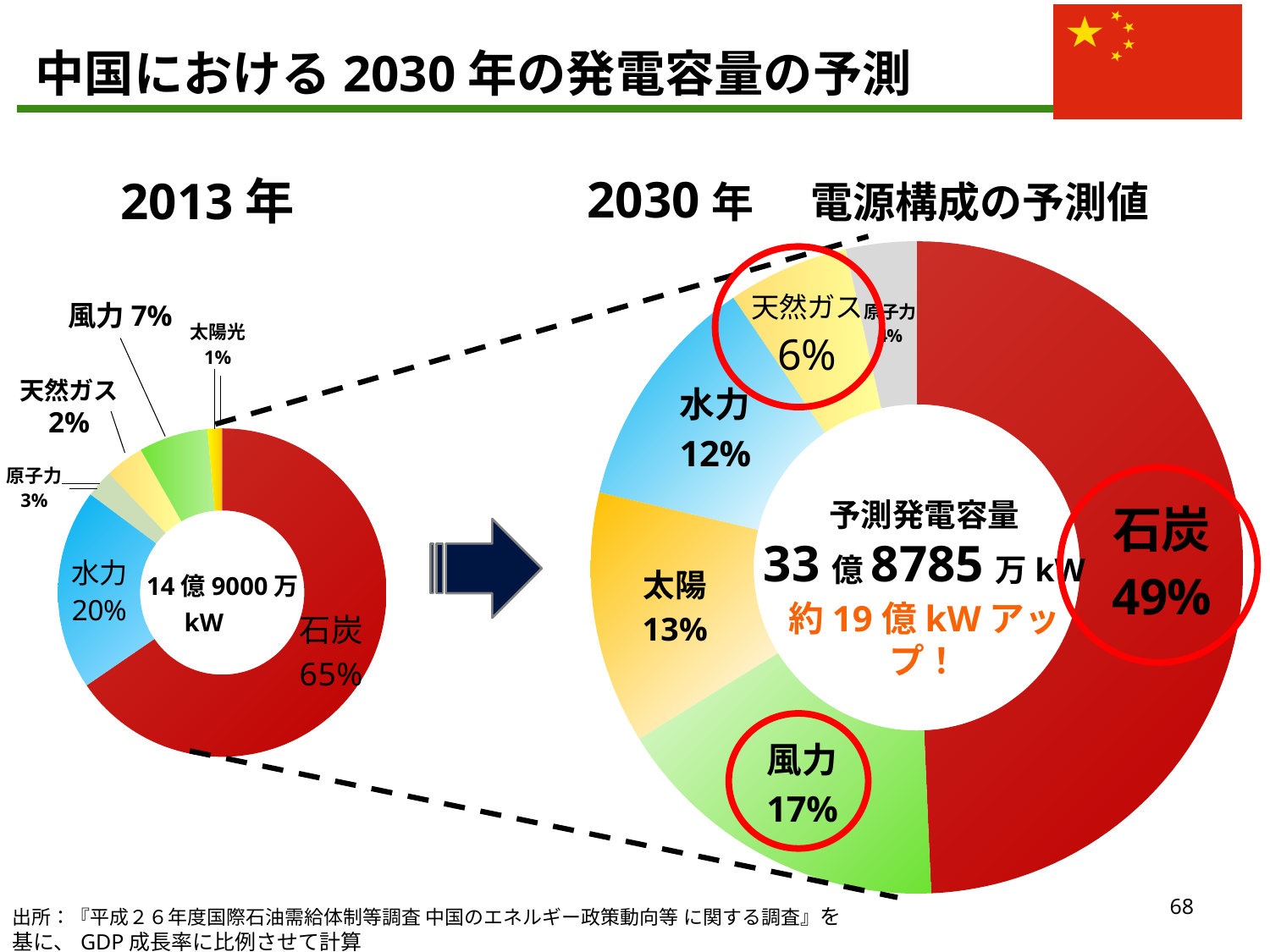
In the 2013年 chart, what share does 風力 have? 7% Which is larger: the share of 石炭 in the 2013年 chart or in the 2030年 chart? 2013年 In the 2030年 chart, what is the difference between the shares of 太陽 and 水力? 1% In the 2013年 chart, which category has the smallest share? 太陽光 In the 2030年 chart, what share does 天然ガス have? 6% In the 2030年 chart, what share does 風力 have? 17% What kind of chart is used for the 2030年 電源構成の予測値? Donut (pie) chart In the 2030年 chart, which category has the largest share? 石炭 What total generation capacity is shown in the centre of the 2030年 chart? 33億8785万kW In the 2013年 chart, what share does 水力 have? 20% In the 2030年 chart, what share does 石炭 have? 49% In the 2013年 chart, what share does 石炭 have? 65%